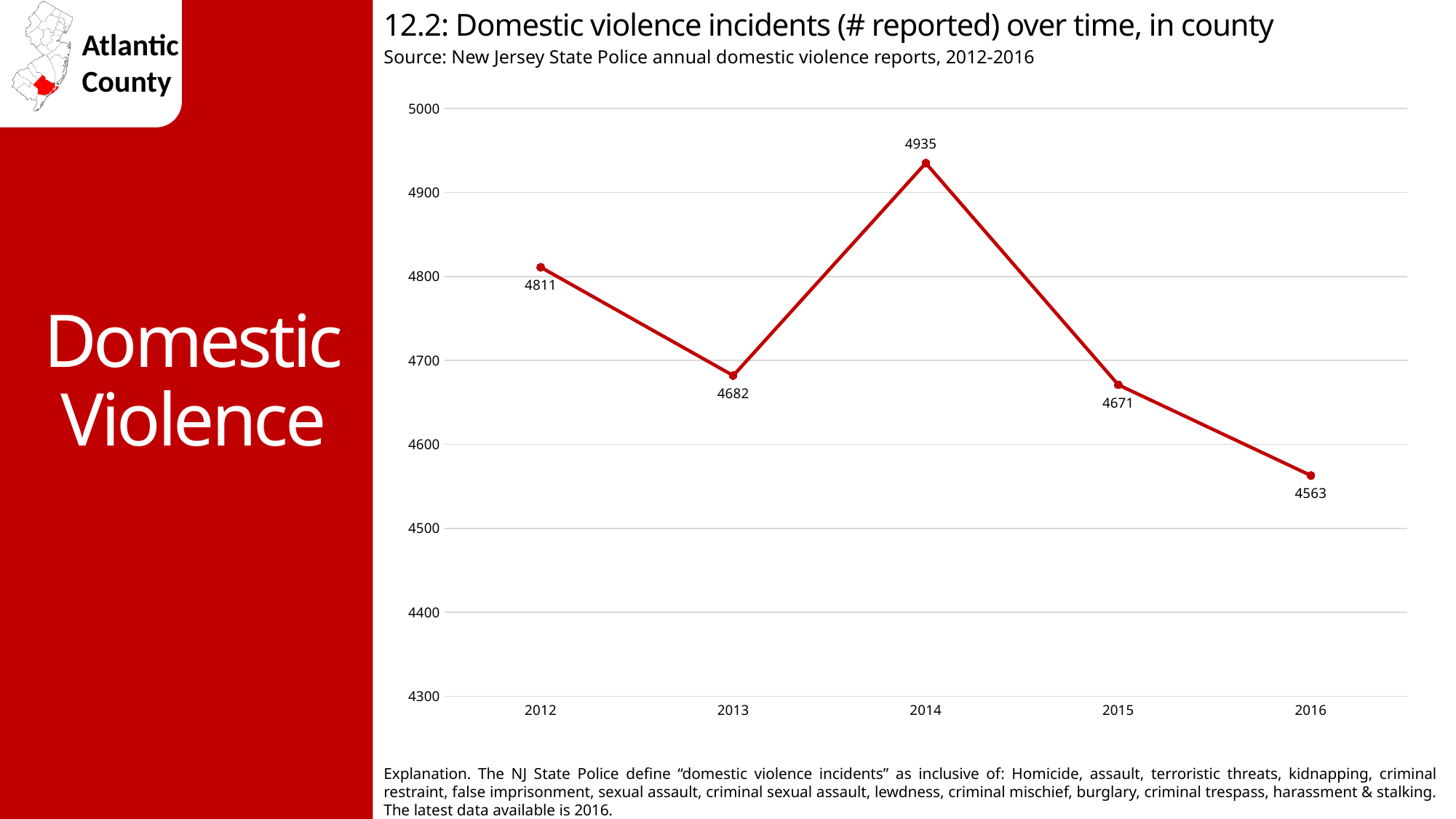
What was the number of reported domestic violence incidents in 2012? 4811 What was the number of reported domestic violence incidents in 2014? 4935 What type of chart is shown on the slide? line chart How many years are plotted on the chart? 5 Is the value for 2015 greater or less than 4700? less Which year had the highest number of reported domestic violence incidents? 2014 What is the difference in reported incidents between 2014 and 2016? 372 Which year had more reported incidents, 2013 or 2015? 2013 What was the number of reported domestic violence incidents in 2016? 4563 What is the difference in reported incidents between 2012 and 2013? 129 Which year had the lowest number of reported domestic violence incidents? 2016 Did the number of reported incidents rise or fall from 2014 to 2016? fall